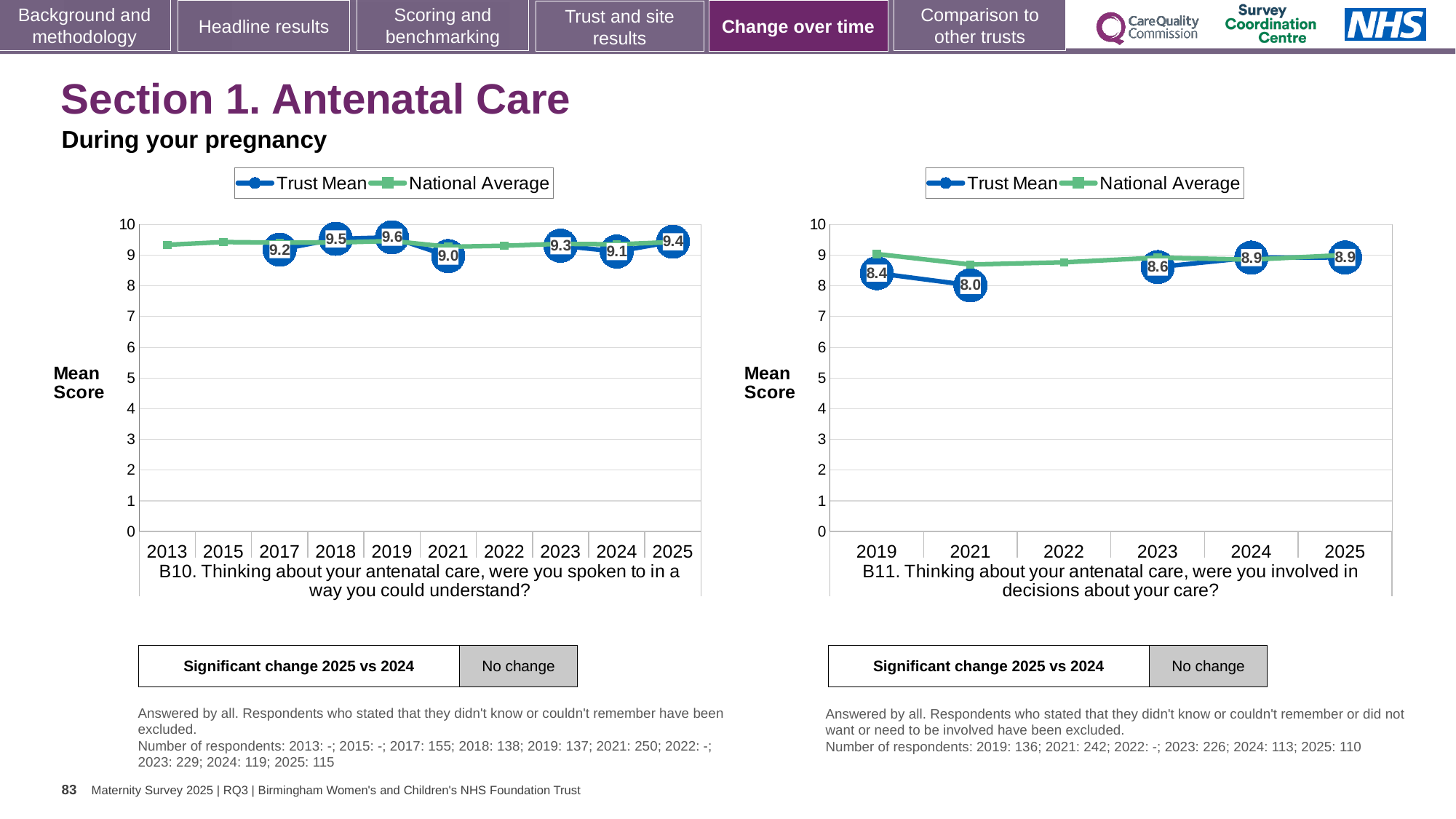
In the B10 chart (left), what is the Trust Mean score for 2019? 9.6 In the B10 chart (left), which year has the highest labelled Trust Mean score? 2019 In the B10 chart (left), what is the difference between the Trust Mean scores for 2019 and 2021? 0.6 In the B11 chart (right), is the Trust Mean value for 2021 greater or less than 9? less In the B11 chart (right), what is the Trust Mean score for 2021? 8.0 In the B10 chart (left), what is the Trust Mean score for 2025? 9.4 In the B11 chart (right), what is the difference between the Trust Mean scores for 2025 and 2021? 0.9 In the B11 chart (right), which year has the lowest Trust Mean score? 2021 How many series does the legend of the B10 chart (left) list? 2 In the B11 chart (right), is the Trust Mean score higher in 2019 or 2021? 2019 What type of chart is the B10 chart (left)? Line chart How many years are shown on the x axis of the B11 chart (right)? 6